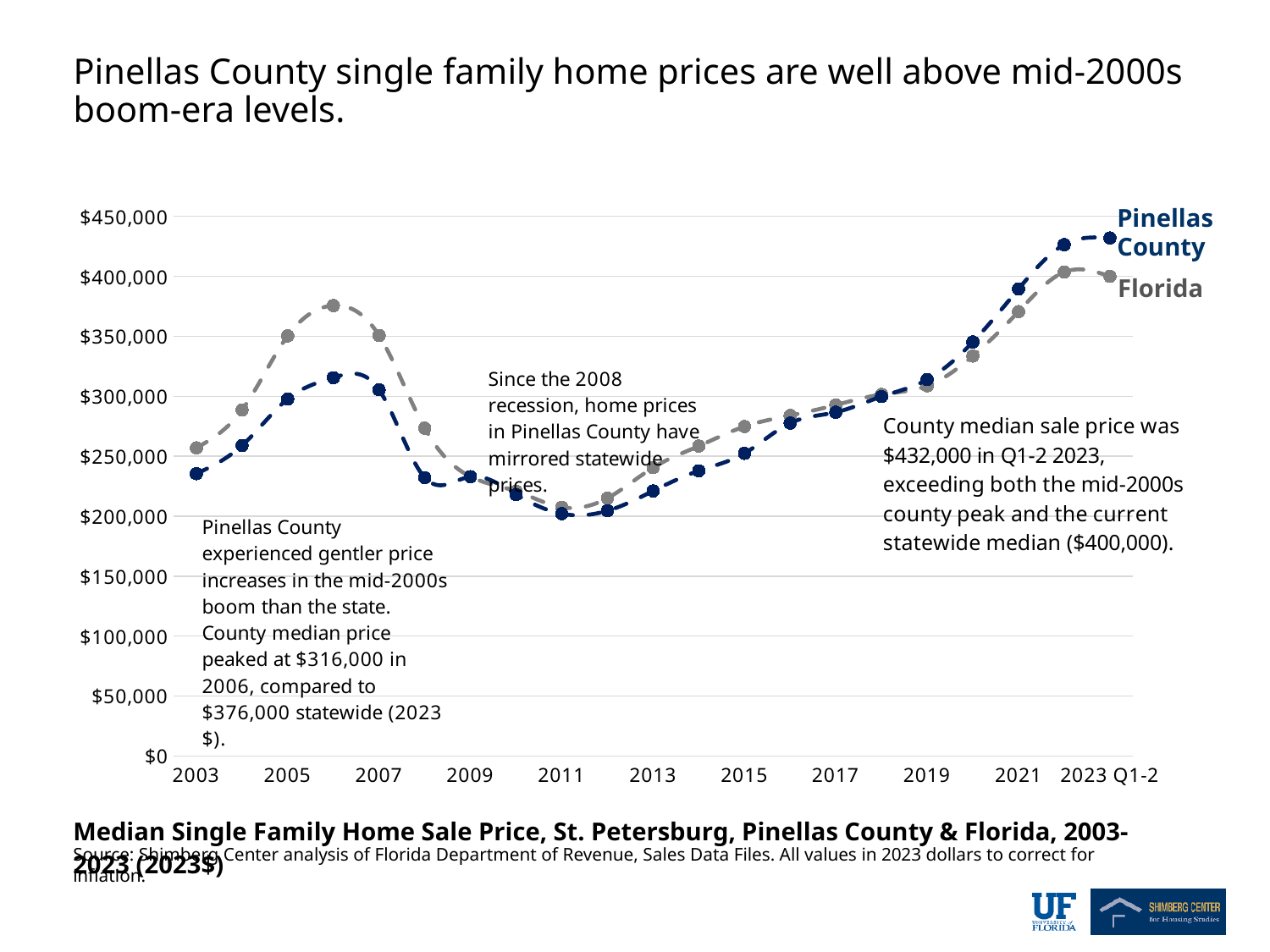
According to the slide, what was the Pinellas County median sale price in Q1-2 2023? $432,000 How many series does the chart show? 2 In 2023 Q1-2, which series had the higher median sale price, Pinellas County or Florida? Pinellas County Do Pinellas County median prices rise or fall between 2011 and 2023 Q1-2? rise In 2006, which series had the higher median sale price, Pinellas County or Florida? Florida Is the Pinellas County value for 2003 greater or less than $250,000? less According to the slide, at what value did the Pinellas County median price peak in 2006? $316,000 What is the difference between the Pinellas County median ($432,000) and the statewide median ($400,000) in Q1-2 2023? $32,000 What are the two series plotted on the chart? Pinellas County and Florida Is the Florida value for 2021 greater or less than $350,000? greater What kind of chart is shown on the slide? line chart According to the slide, what was the statewide (Florida) median sale price in Q1-2 2023? $400,000